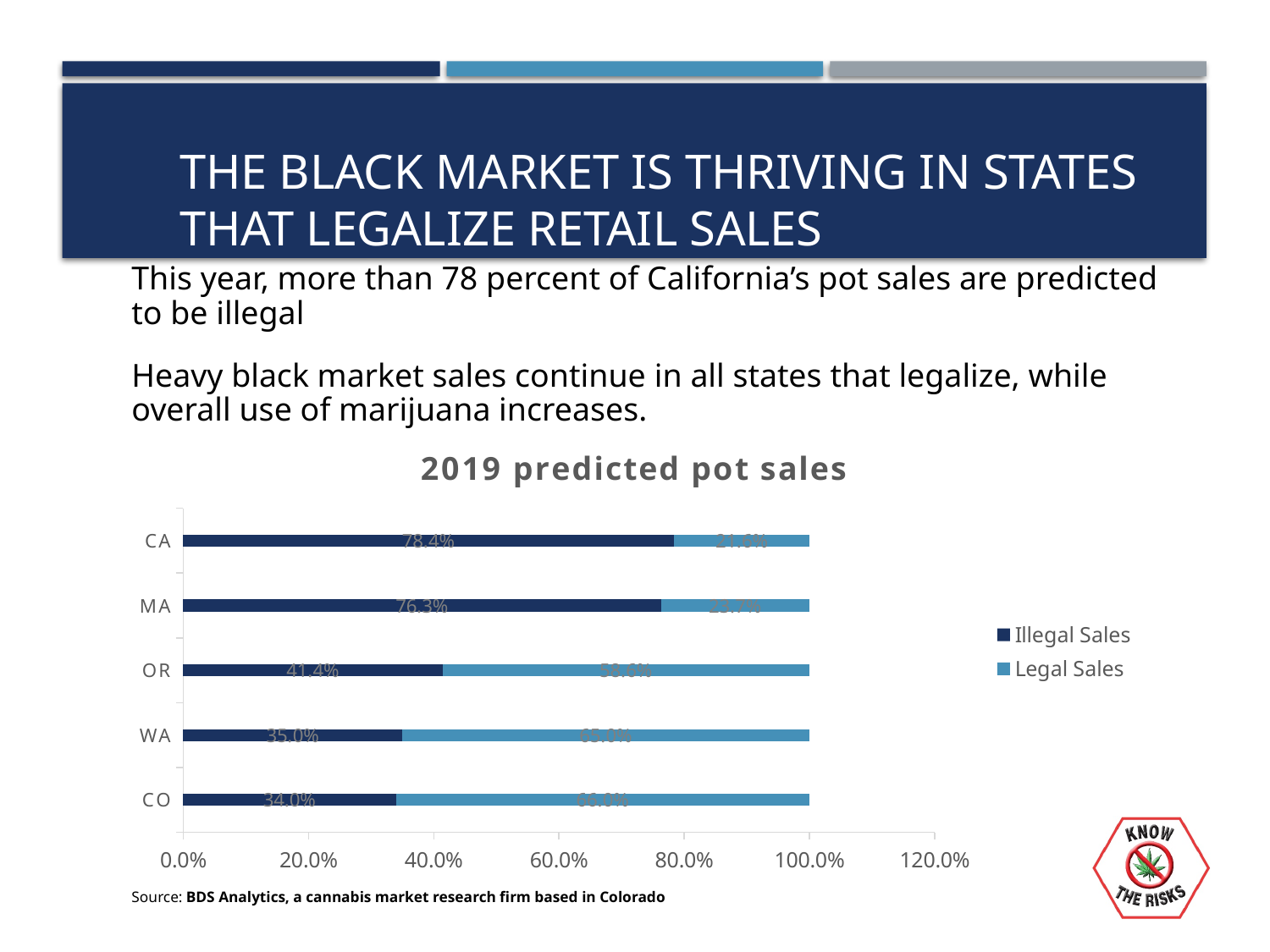
How many series does the chart legend list? 2 What is the title of the chart? 2019 predicted pot sales How many states are shown on the chart? 5 What is the difference between the Illegal Sales values for CA and WA? 43.4% What is the Illegal Sales value for OR? 41.4% What is the Illegal Sales value for CA? 78.4% What type of chart is shown on the slide? Stacked bar chart What is the Illegal Sales value for CO? 34.0% What is the Illegal Sales value for MA? 76.3% Is the Legal Sales value for WA greater or less than 60.0%? greater Which state has the lowest Illegal Sales share? CO Which state has the highest Illegal Sales share? CA